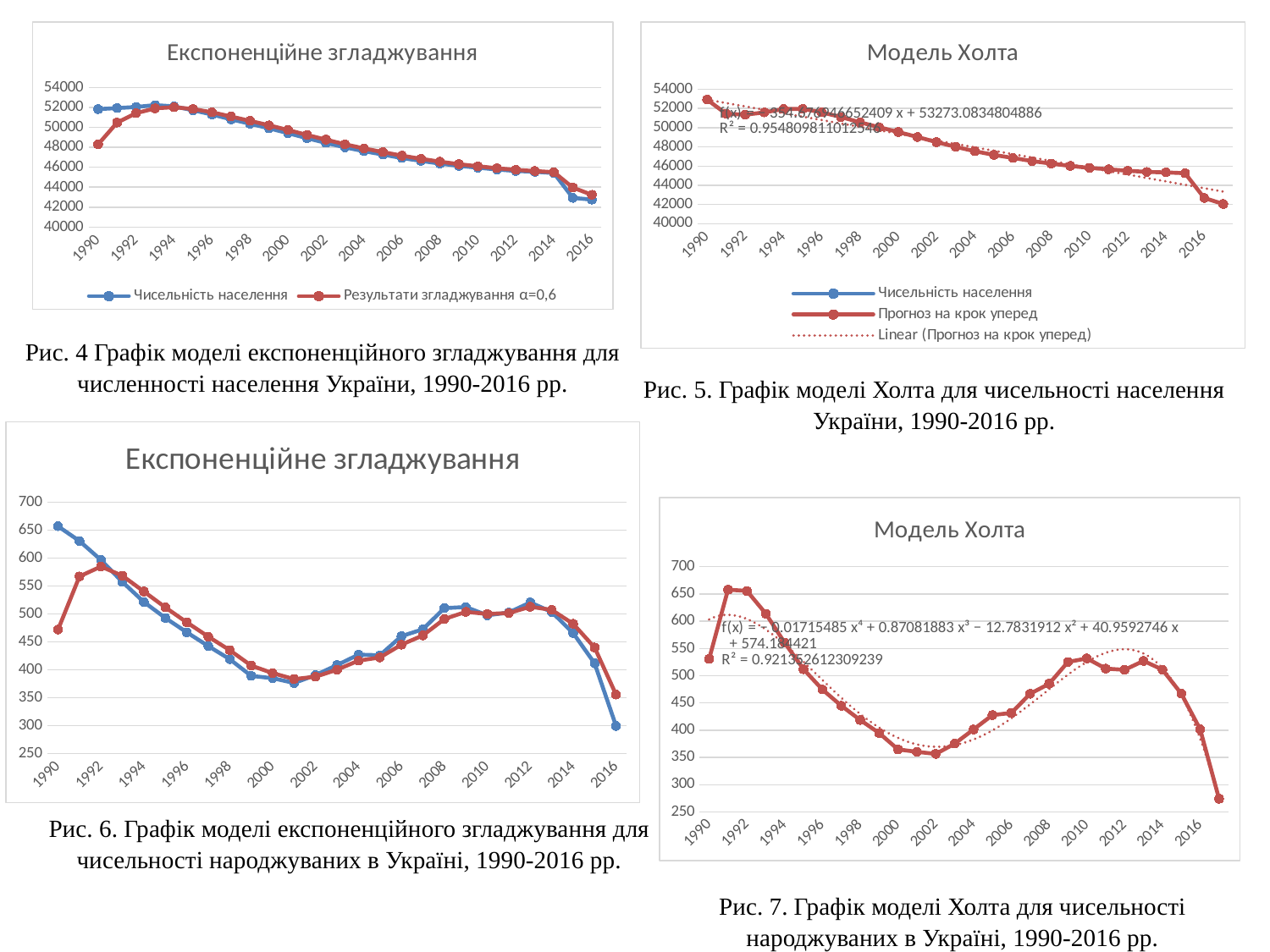
In the bottom-left chart (Рис. 6), does the blue line rise or fall between 2002 and 2012? Rise What kind of chart is the top-left chart titled "Експоненційне згладжування" (Рис. 4)? Line chart In the bottom-left chart (Рис. 6), which year has the lowest value on the blue line? 2016 How many series does the legend of the top-right chart "Модель Холта" (Рис. 5) list? 3 What R² value is printed on the bottom-right chart "Модель Холта" (Рис. 7)? R² = 0.921352612309239 In the top-left chart (Рис. 4), is the "Чисельність населення" value for 2016 greater or less than 44000? less In the top-left chart (Рис. 4), does the "Чисельність населення" line overall rise or fall from 1990 to 2016? Fall In the top-right chart (Рис. 5), is the "Прогноз на крок уперед" value for 1990 greater or less than 52000? greater In the bottom-left chart (Рис. 6), which year has the highest value on the blue line? 1990 In the bottom-left chart (Рис. 6), is the blue line value for 2016 greater or less than 350? less How many series does the legend of the top-left chart "Експоненційне згладжування" (Рис. 4) list? 2